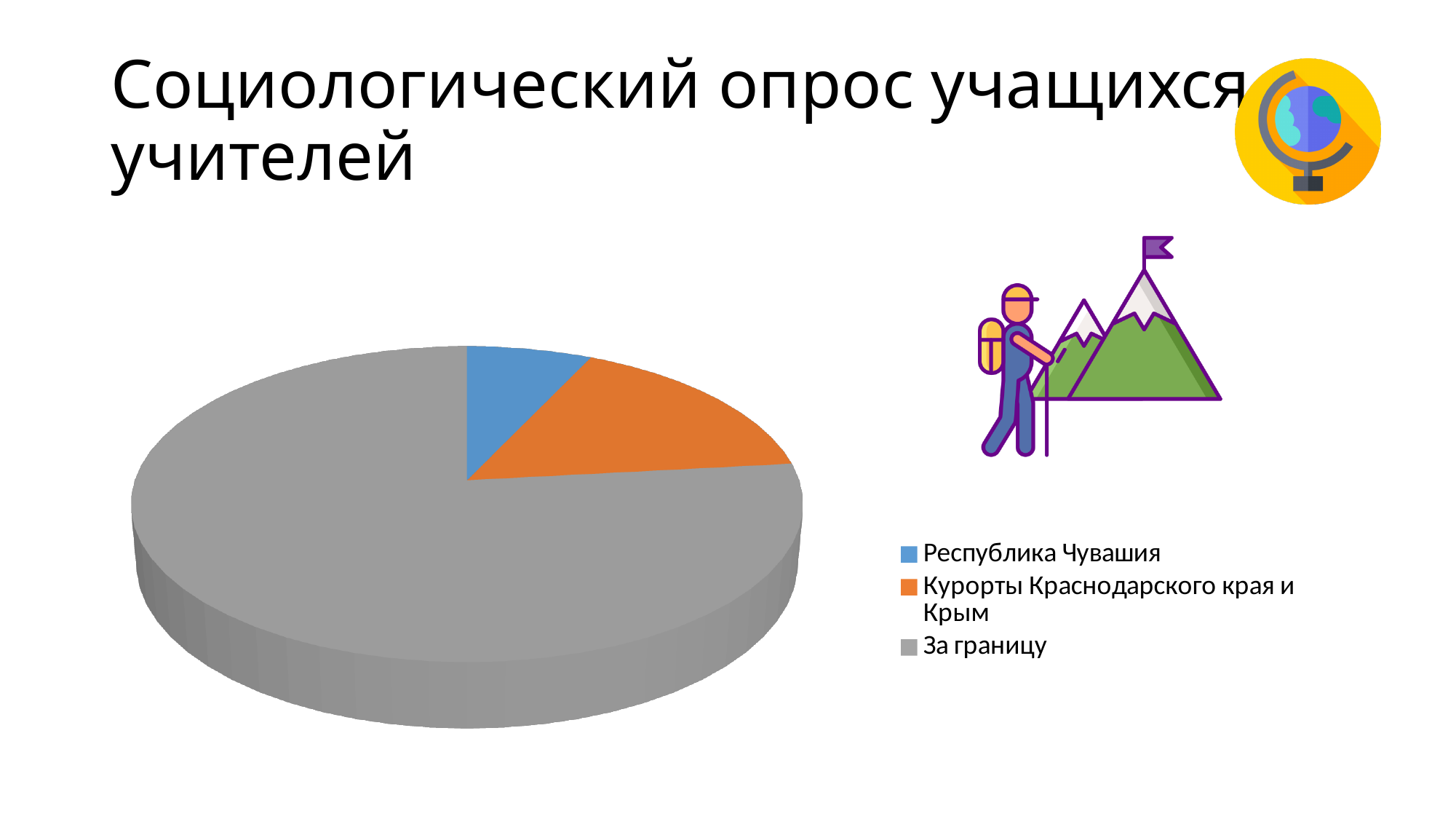
Which slice is larger: За границу or Курорты Краснодарского края и Крым? За границу Which category has the smallest slice of the pie chart? Республика Чувашия How many slices does the pie chart have? 3 Which category is shown in blue in the pie chart? Республика Чувашия What colour is the slice for За границу? gray How many entries does the legend of the pie chart list? 3 What kind of chart is shown on the slide? pie chart Which slice is larger: Республика Чувашия or Курорты Краснодарского края и Крым? Курорты Краснодарского края и Крым Which category has the largest slice of the pie chart? За границу